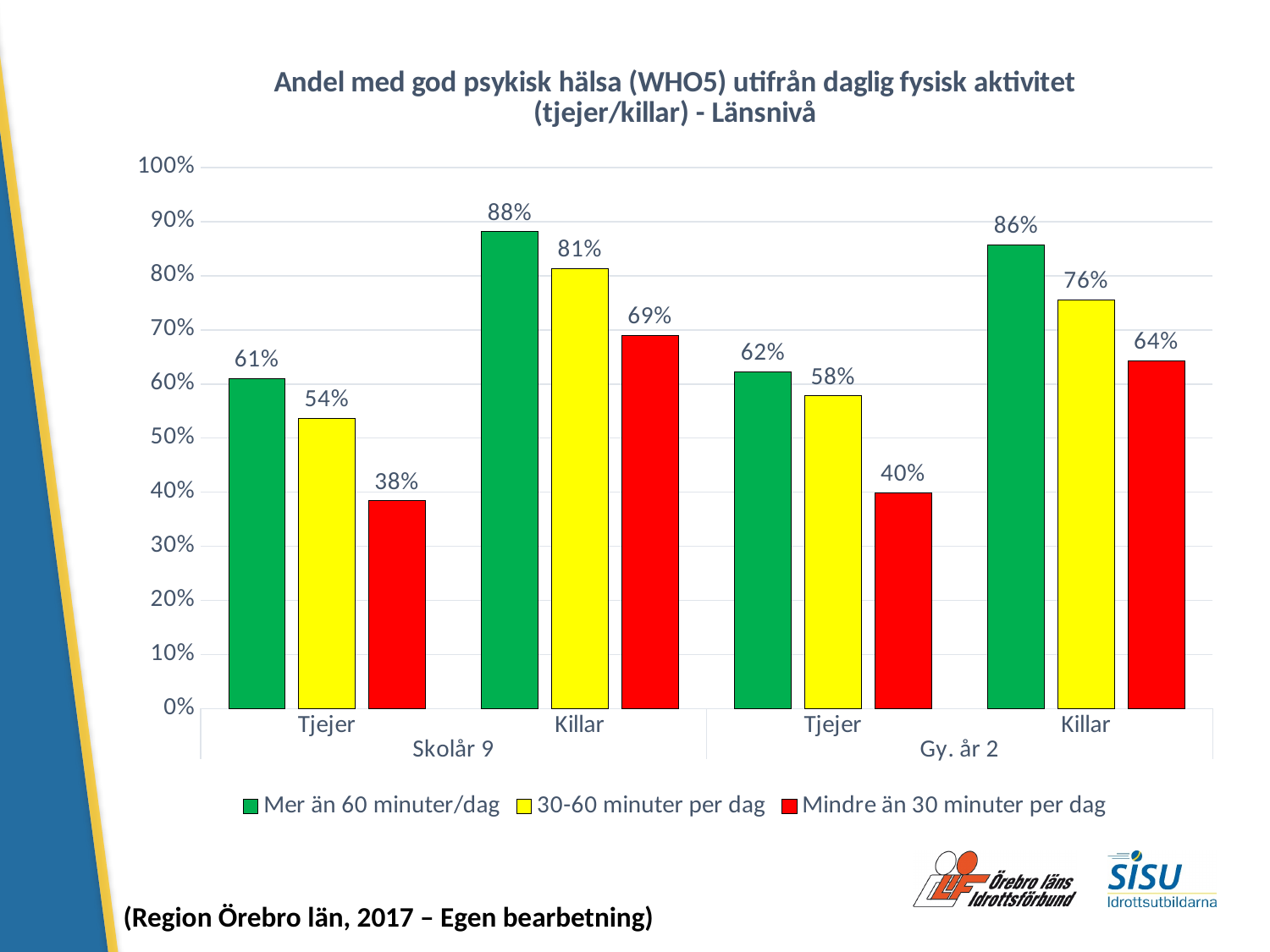
What is the value for 'Mindre än 30 minuter per dag' among Killar in Gy. år 2? 64% Which group and activity level has the lowest value in the chart? Tjejer, Skolår 9, Mindre än 30 minuter per dag (38%) How many series does the legend list? 3 What kind of chart is shown on the slide? Bar chart What is the value for 'Mer än 60 minuter/dag' among Tjejer in Skolår 9? 61% Which colour represents 'Mindre än 30 minuter per dag' in the chart? Red Which is larger: '30-60 minuter per dag' for Killar in Skolår 9 or for Killar in Gy. år 2? Killar in Skolår 9 (81%) What is the difference between 'Mer än 60 minuter/dag' and 'Mindre än 30 minuter per dag' for Tjejer in Skolår 9? 23 percentage points Is the value for 'Mindre än 30 minuter per dag' among Tjejer in Gy. år 2 greater or less than 50%? less How many bars are plotted in the chart? 12 What is the value for '30-60 minuter per dag' among Tjejer in Gy. år 2? 58% Which group and activity level has the highest value in the chart? Killar, Skolår 9, Mer än 60 minuter/dag (88%)